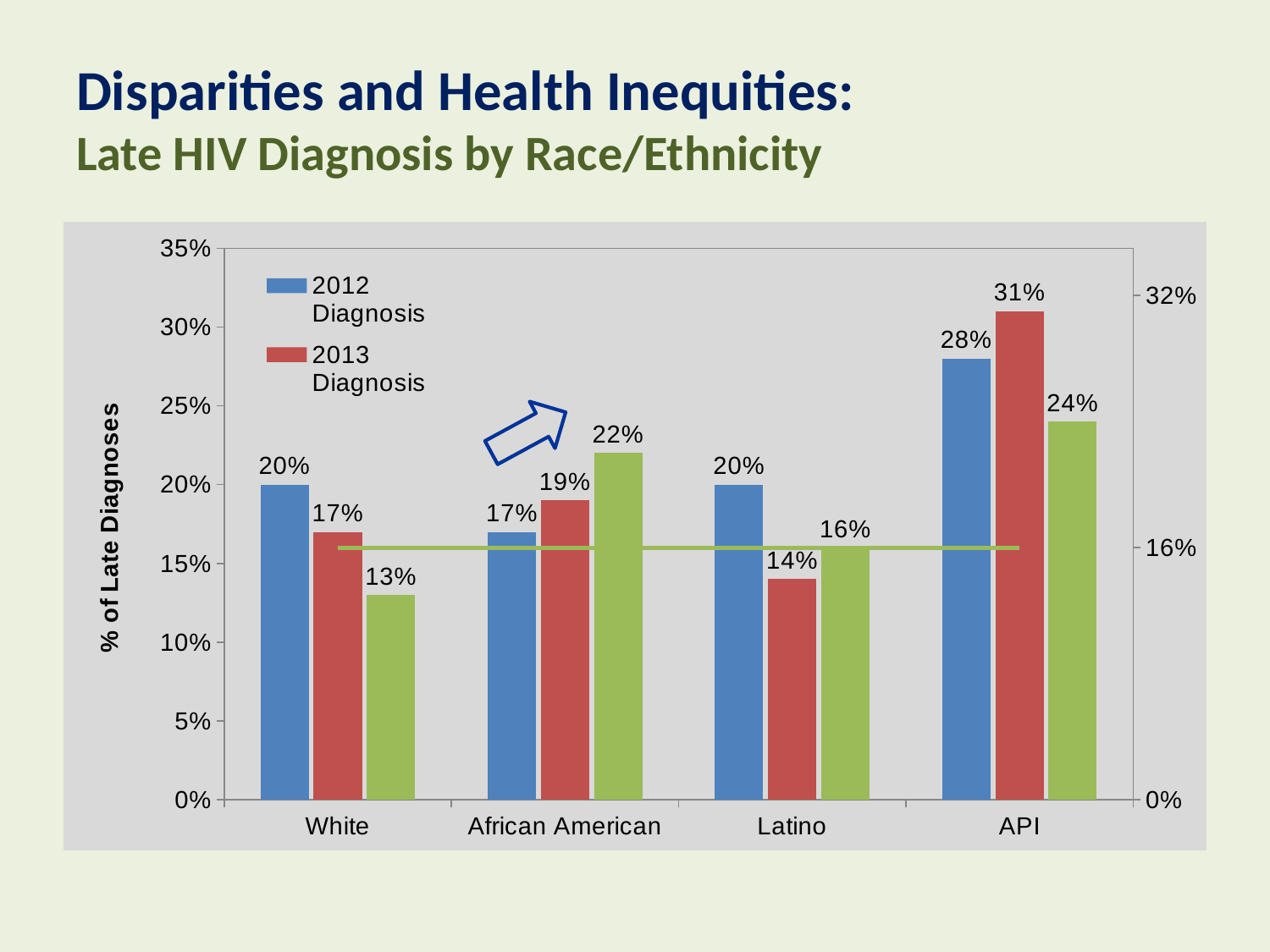
What is the difference between the 2013 Diagnosis and 2012 Diagnosis values for API? 3% Which is larger for African American: the 2012 Diagnosis value or the 2013 Diagnosis value? 2013 Diagnosis What is the 2012 Diagnosis value for White? 20% What is the 2013 Diagnosis value for API? 31% How many series does the legend list? 2 What is the 2013 Diagnosis value for Latino? 14% Which race/ethnicity has the lowest 2013 Diagnosis value? Latino How many race/ethnicity categories are shown on the x axis? 4 What is the difference between the 2012 Diagnosis and 2013 Diagnosis values for Latino? 6% What is the 2012 Diagnosis value for African American? 17% Which race/ethnicity has the highest 2013 Diagnosis value? API What kind of chart is shown on the slide? Combination bar and line chart